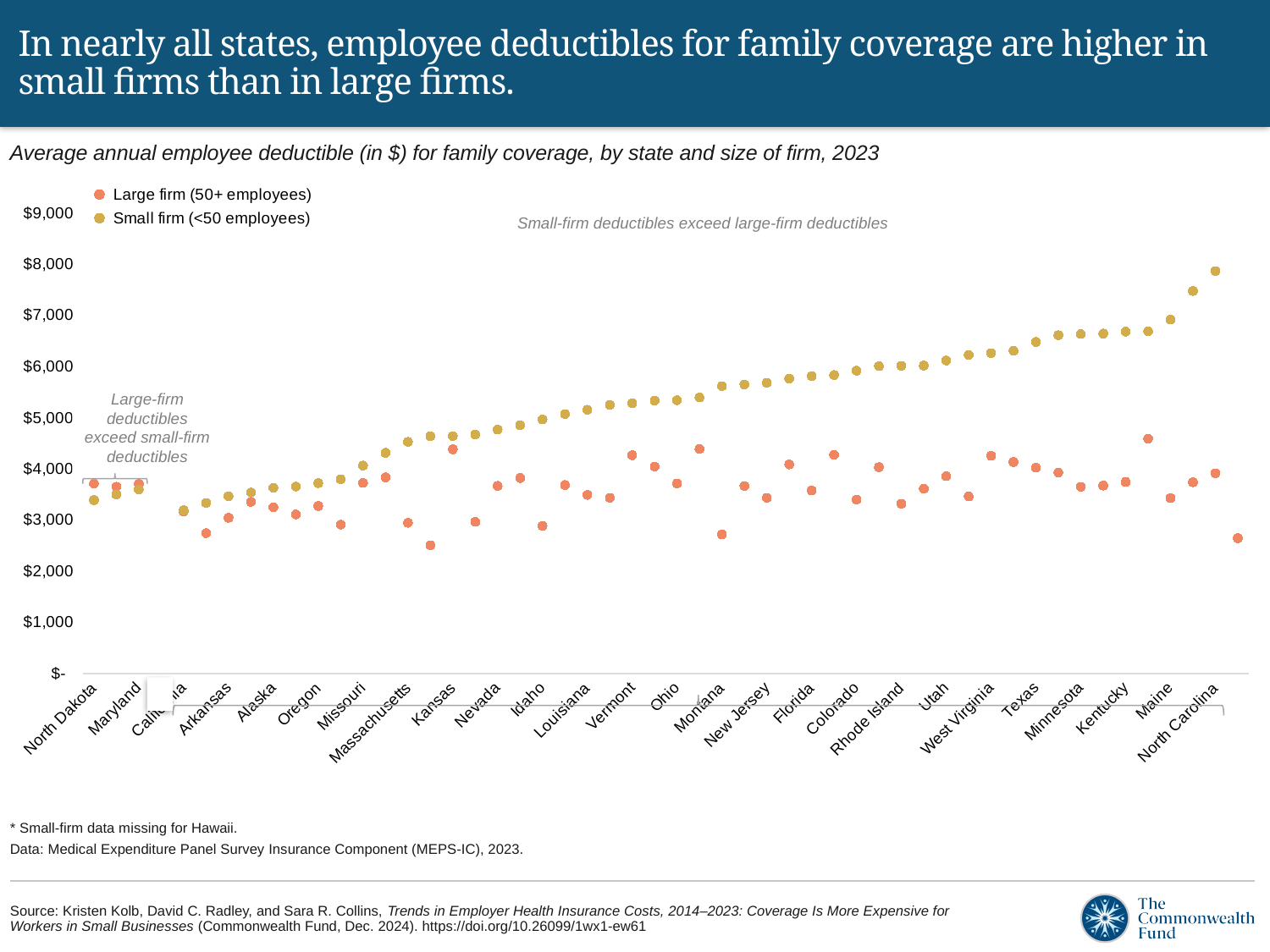
Is the large-firm deductible for North Carolina greater or less than $3,000? greater Which two series are listed in the legend? Large firm (50+ employees) and Small firm (<50 employees) How many series does the legend list? 2 Which colour represents small firms (<50 employees) in the chart? Gold/yellow Is the small-firm deductible for North Carolina greater or less than $7,000? greater What kind of chart is shown on the slide? Dot (scatter) chart Which state has the highest small-firm deductible? North Carolina Do the small-firm deductibles rise or fall moving from left to right along the x axis? Rise Which state is noted as missing small-firm data? Hawaii Is the small-firm deductible for Maine greater or less than $6,000? greater For North Carolina, which is larger: the small-firm deductible or the large-firm deductible? Small-firm deductible